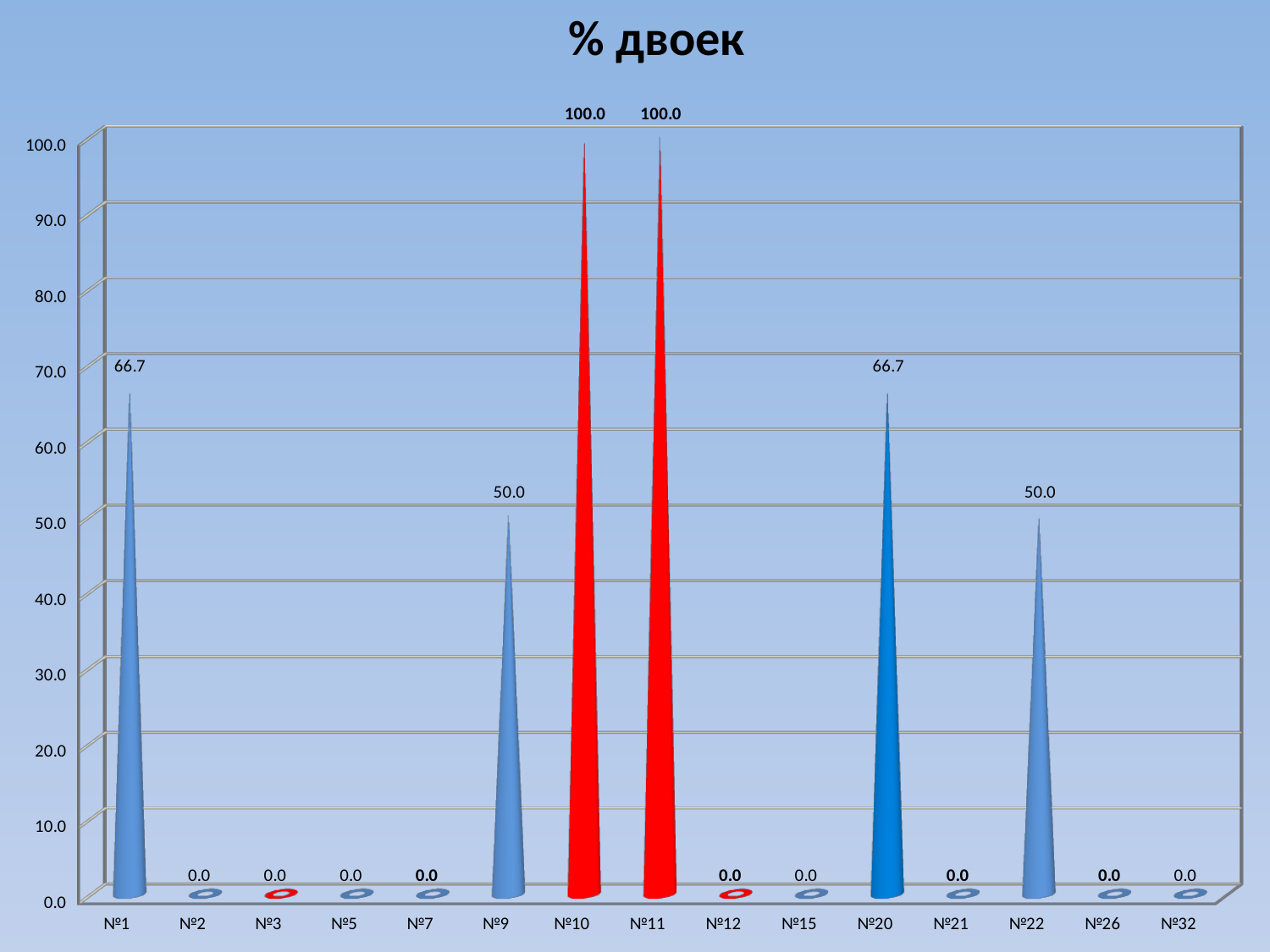
Which has the larger value, №10 or №22? №10 What is the value for №1? 66.7 What is the highest value plotted on the chart? 100.0 How many categories are shown on the x axis? 15 What is the value for №32? 0.0 What is the value for №20? 66.7 What is the value for №9? 50.0 What is the title of the chart? % двоек What is the value for №12? 0.0 Is the value for №22 greater or less than 40.0? greater What is the difference between the values for №1 and №9? 16.7 What is the difference between the values for №10 and №20? 33.3